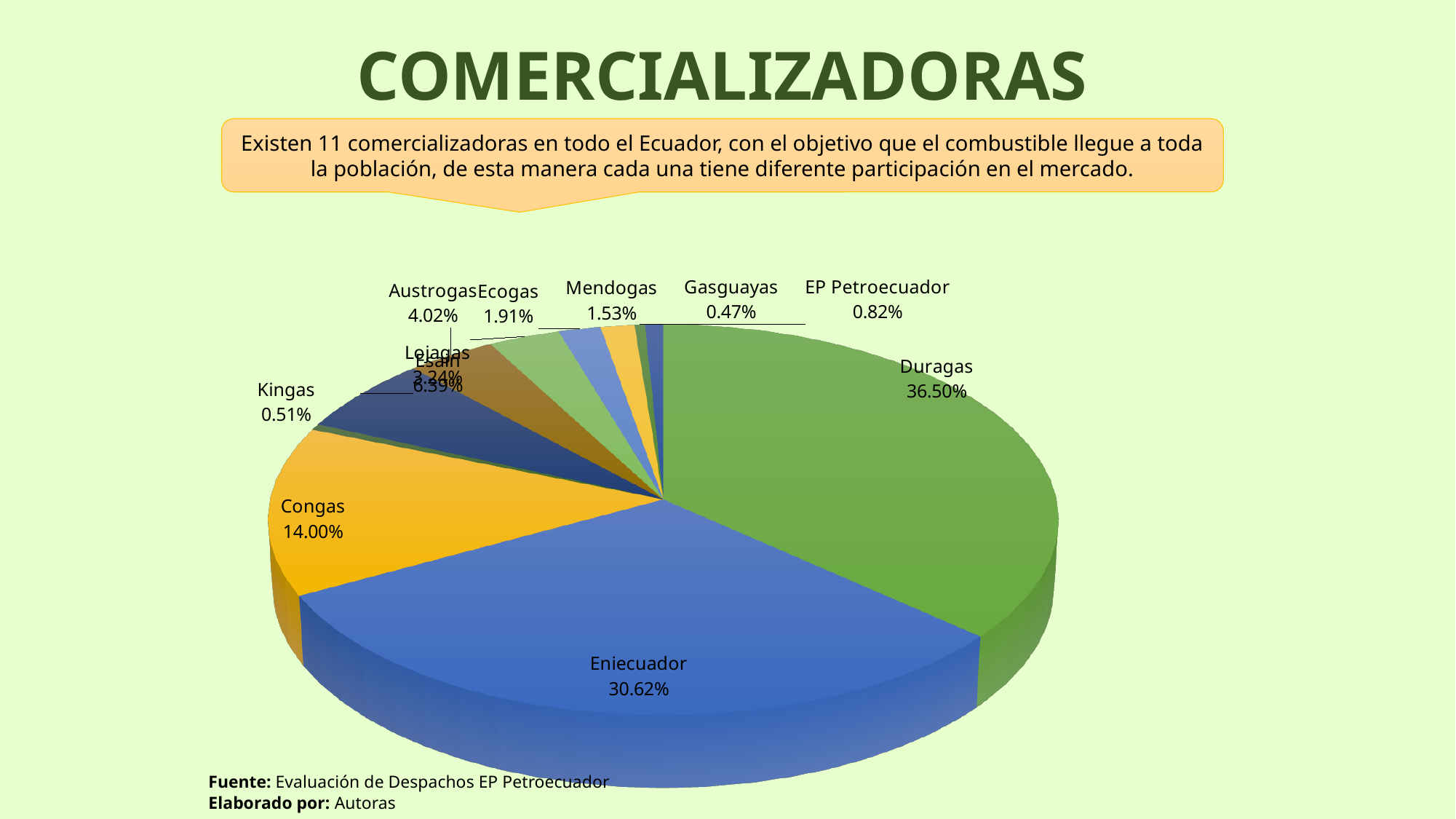
How many comercializadoras (slices) are shown in the pie chart? 11 What is the value shown for EP Petroecuador? 0.82% Which comercializadora has the largest share of the pie? Duragas What is the combined share of Mendogas and Ecogas? 3.44% Which comercializadora has the smallest share of the pie? Gasguayas What share of the pie does Duragas hold? 36.50% What is the value shown for Eniecuador? 30.62% What is the value shown for Congas? 14.00% What is the value shown for Austrogas? 4.02% Which has a larger share, Congas or Austrogas? Congas What type of chart is shown on the slide? pie chart What is the difference between the shares of Duragas and Eniecuador? 5.88%